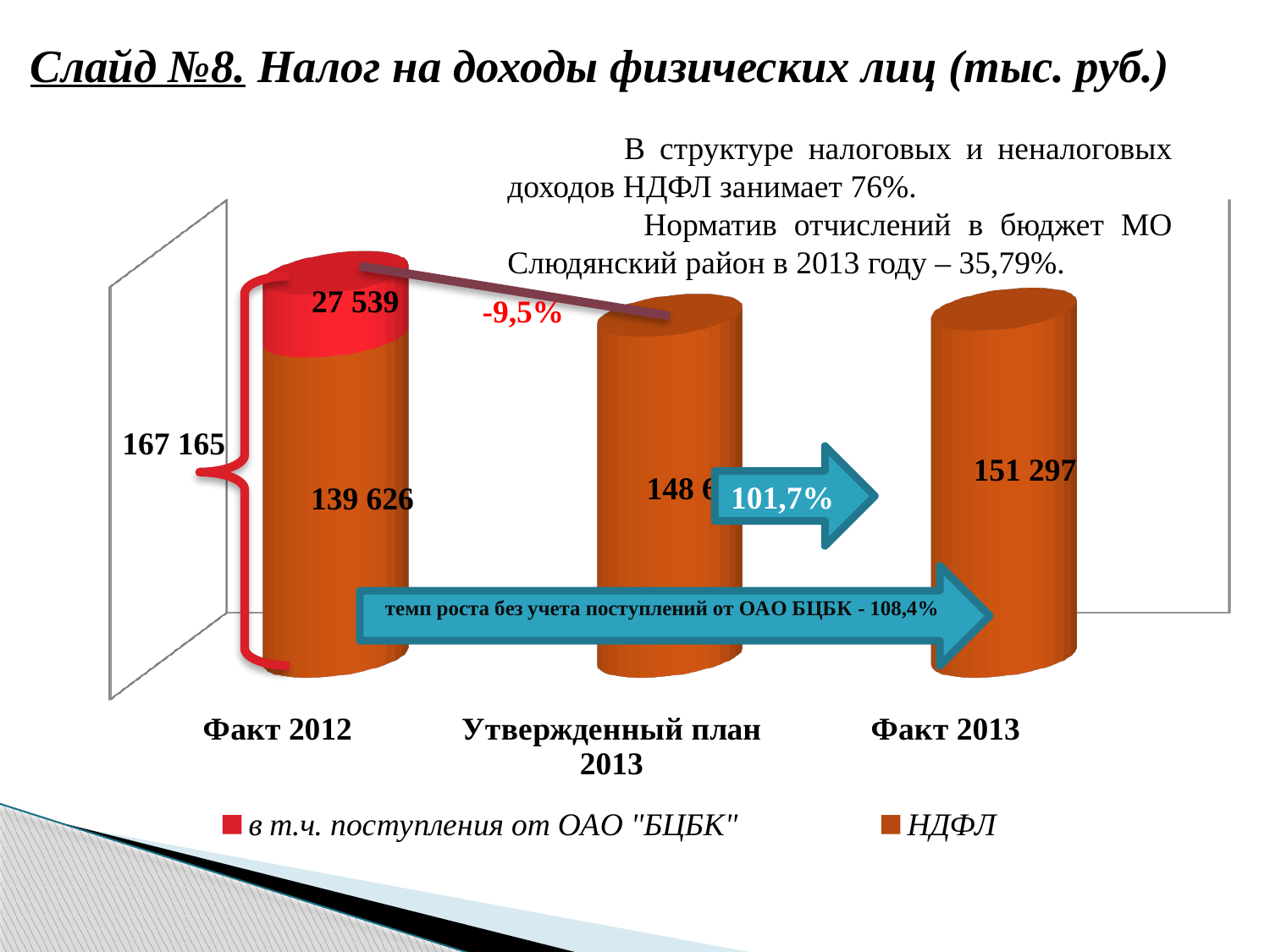
What is the НДФЛ value for Факт 2013? 151 297 How many series does the legend list? 2 Which category includes a red segment for поступления от ОАО "БЦБК"? Факт 2012 What is the difference between the НДФЛ value for Факт 2013 and for Факт 2012? 11 671 Which category has the lowest НДФЛ value? Факт 2012 Which is larger, the НДФЛ value for Факт 2013 or for Факт 2012? Факт 2013 What is the total of the stacked bar for Факт 2012? 167 165 How many categories are shown on the x axis of the chart? 3 What is the value of поступления от ОАО "БЦБК" for Факт 2012? 27 539 What kind of chart is shown on the slide? Bar chart Which category has the highest НДФЛ value? Факт 2013 What is the НДФЛ value for Факт 2012? 139 626